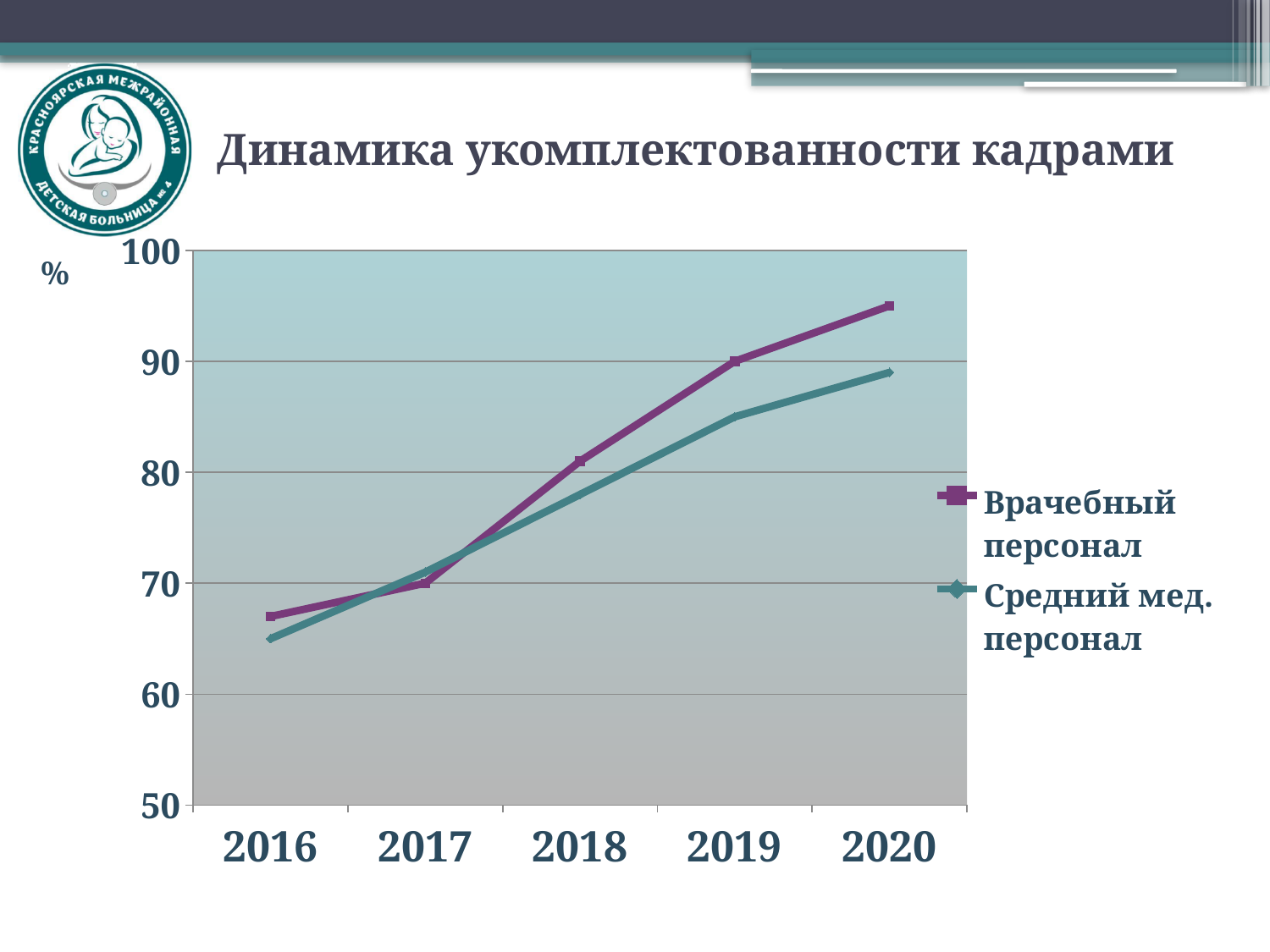
Is the value for Средний мед. персонал in 2016 greater or less than 70? less What is the title of the chart? Динамика укомплектованности кадрами In which year is the value for Средний мед. персонал lowest? 2016 How many series does the legend list? 2 Do the values for Врачебный персонал rise or fall from 2016 to 2020? rise Which series has the larger value in 2020, Врачебный персонал or Средний мед. персонал? Врачебный персонал Is the value for Врачебный персонал in 2020 greater or less than 90? greater What kind of chart is shown on the slide? line chart How many years are shown on the x axis? 5 In which year is the value for Врачебный персонал highest? 2020